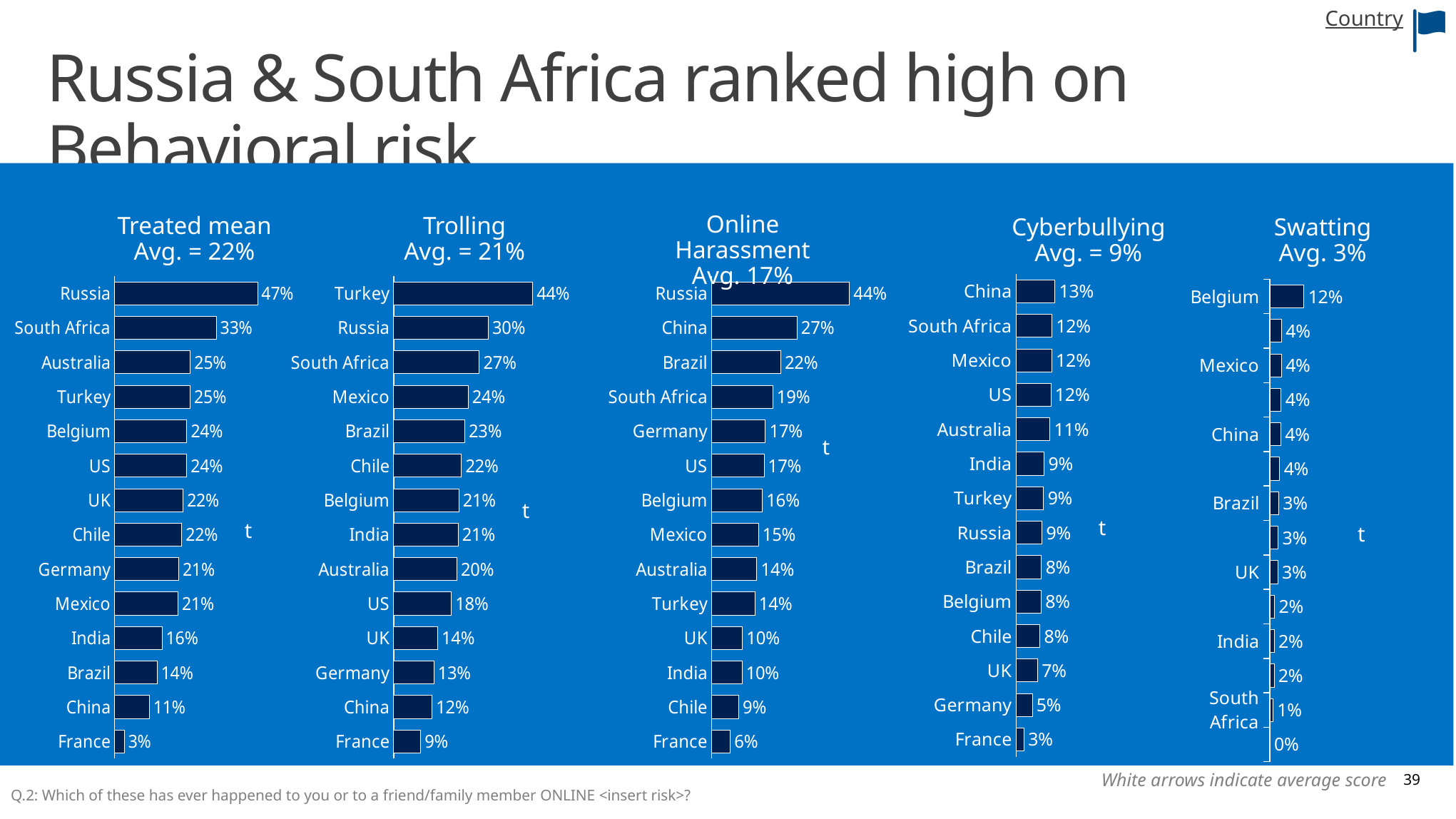
In the Cyberbullying chart, what is the value for China? 13% In the Online Harassment chart, which country has the lowest value? France In the Swatting chart, what is the value for Belgium? 12% In the Treated mean chart, what is the value for Russia? 47% In the Trolling chart, which is larger, the value for Mexico or the value for Brazil? Mexico In the Treated mean chart, what is the difference between Russia and South Africa? 14% How many countries are shown in the Online Harassment chart? 14 What average is shown in the title of the Trolling chart? Avg. = 21% In the Trolling chart, which country has the highest value? Turkey In the Online Harassment chart, what is the value for Germany? 17% In the Cyberbullying chart, what is the difference between China and France? 10% What kind of chart is the Cyberbullying chart? Bar chart